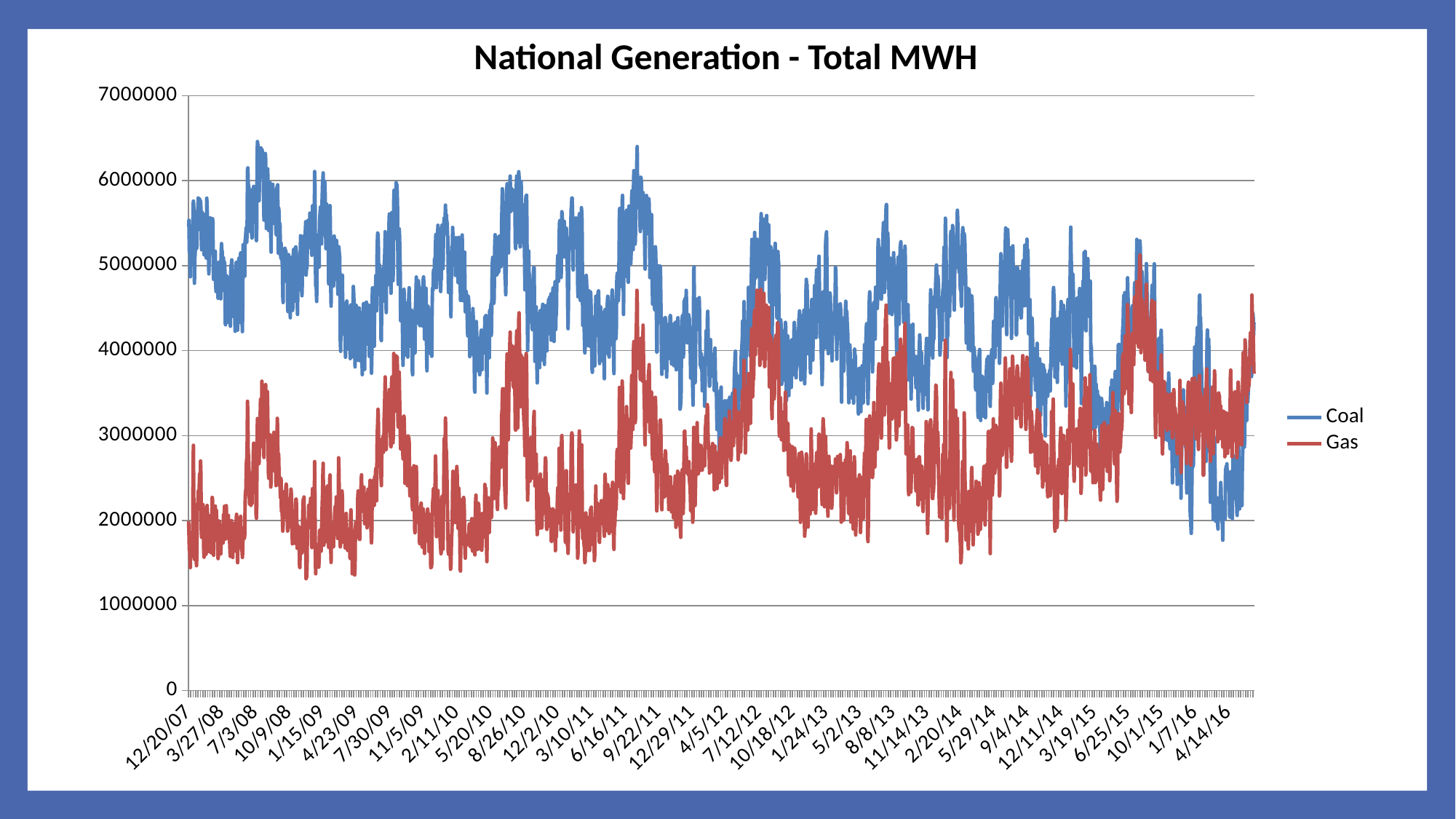
Is the value for Coal at 12/20/07 greater or less than 4000000? greater Is the value for Gas at 12/20/07 greater or less than 3000000? less Does the Coal series generally rise or fall from 12/20/07 to 2016? fall At 12/20/07, which series has the larger value, Coal or Gas? Coal How many series does the legend list? 2 What is the title of the chart? National Generation - Total MWH Around 4/14/16, which series has the larger value, Coal or Gas? Gas Does the Gas series generally rise or fall from 12/20/07 to 2016? rise Is the value for Coal around 4/14/16 greater or less than 3000000? less Which colour represents the Gas series in the chart? red What kind of chart is shown on the slide? line chart